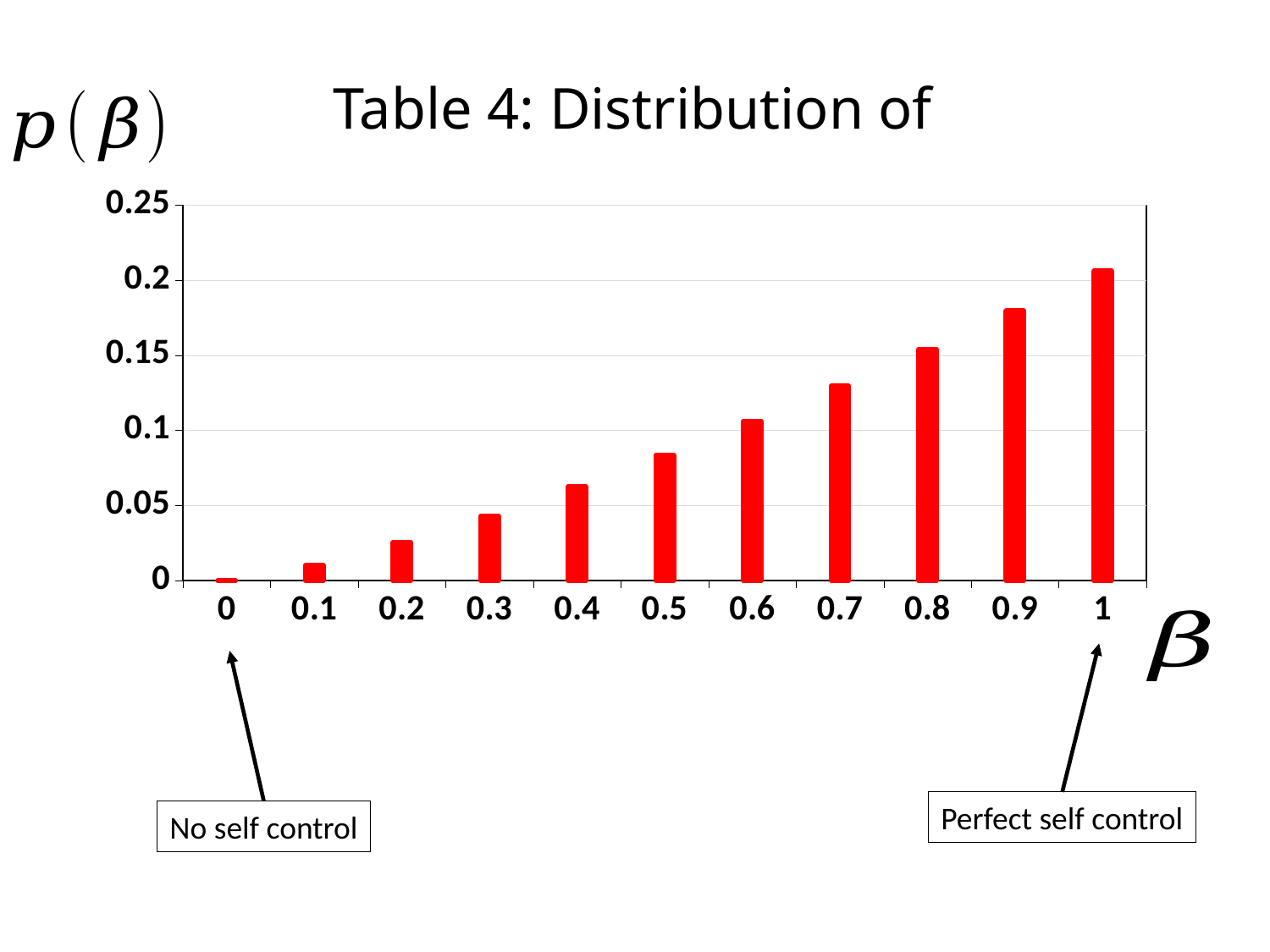
Is the value of p(β) for β = 0.4 greater or less than 0.05? greater What is the title of the chart? Table 4: Distribution of What kind of chart is shown on the slide? bar chart Do the values of p(β) rise or fall as β increases from 0 to 1? rise What label is attached by an arrow to the β = 1 end of the axis? Perfect self control Is the value of p(β) for β = 1 greater or less than 0.2? greater Which has a larger p(β): β = 0.9 or β = 0.5? 0.9 Which β value has the highest p(β)? 1 Which β value has the lowest p(β)? 0 How many bars (β values) are plotted in the chart? 11 Is the value of p(β) for β = 0.5 greater or less than 0.1? less